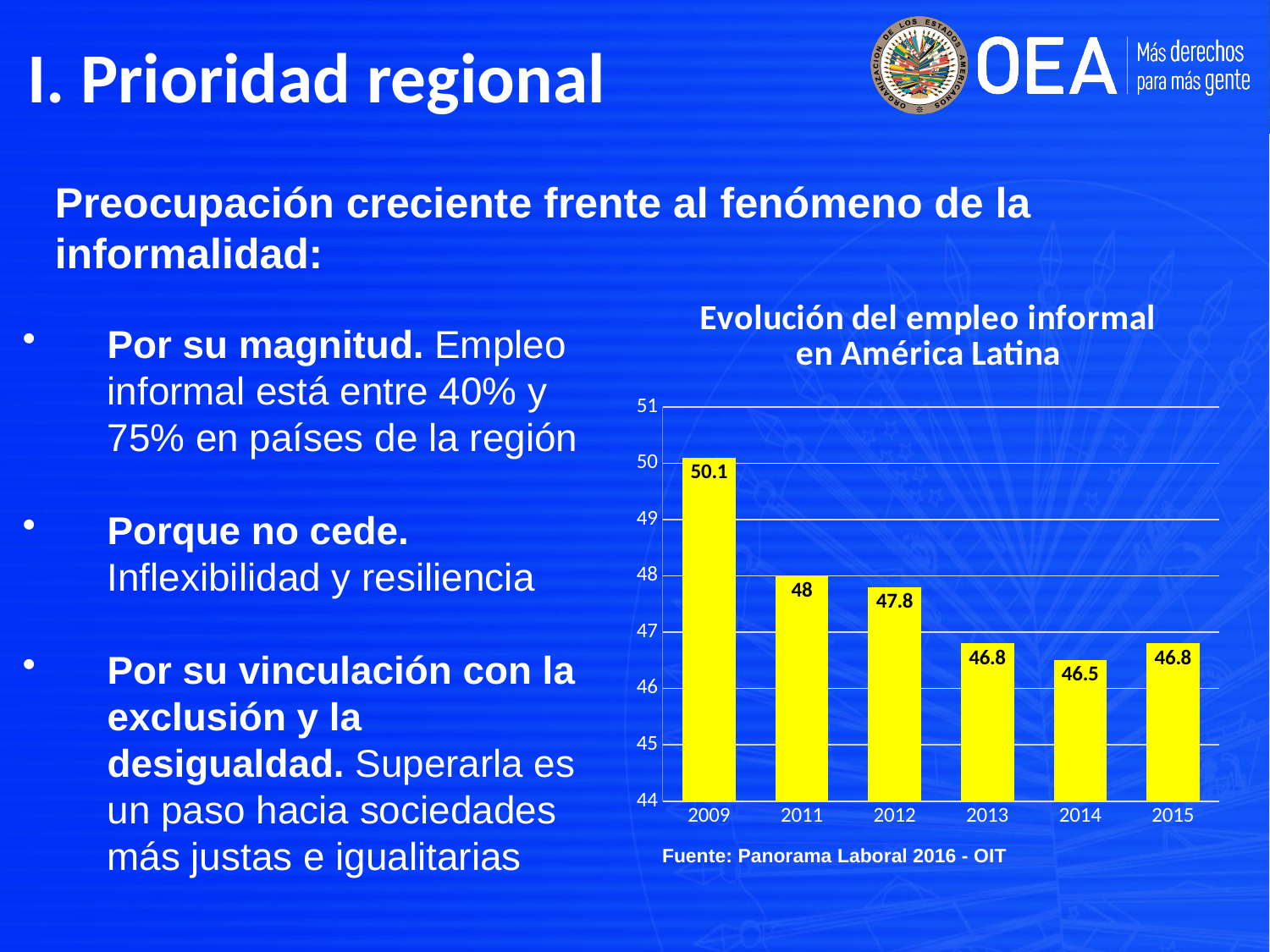
What kind of chart is this? bar chart What is the value for 2012? 47.8 Which is larger, the value for 2011 or the value for 2013? 2011 What is the difference between the values for 2009 and 2015? 3.3 What is the title of the chart? Evolución del empleo informal en América Latina How many years are shown on the x axis? 6 What is the value for 2009? 50.1 What is the difference between the values for 2011 and 2012? 0.2 Which year has the highest value? 2009 Which year has the lowest value? 2014 Is the value for 2013 greater or less than 47? less What is the value for 2014? 46.5